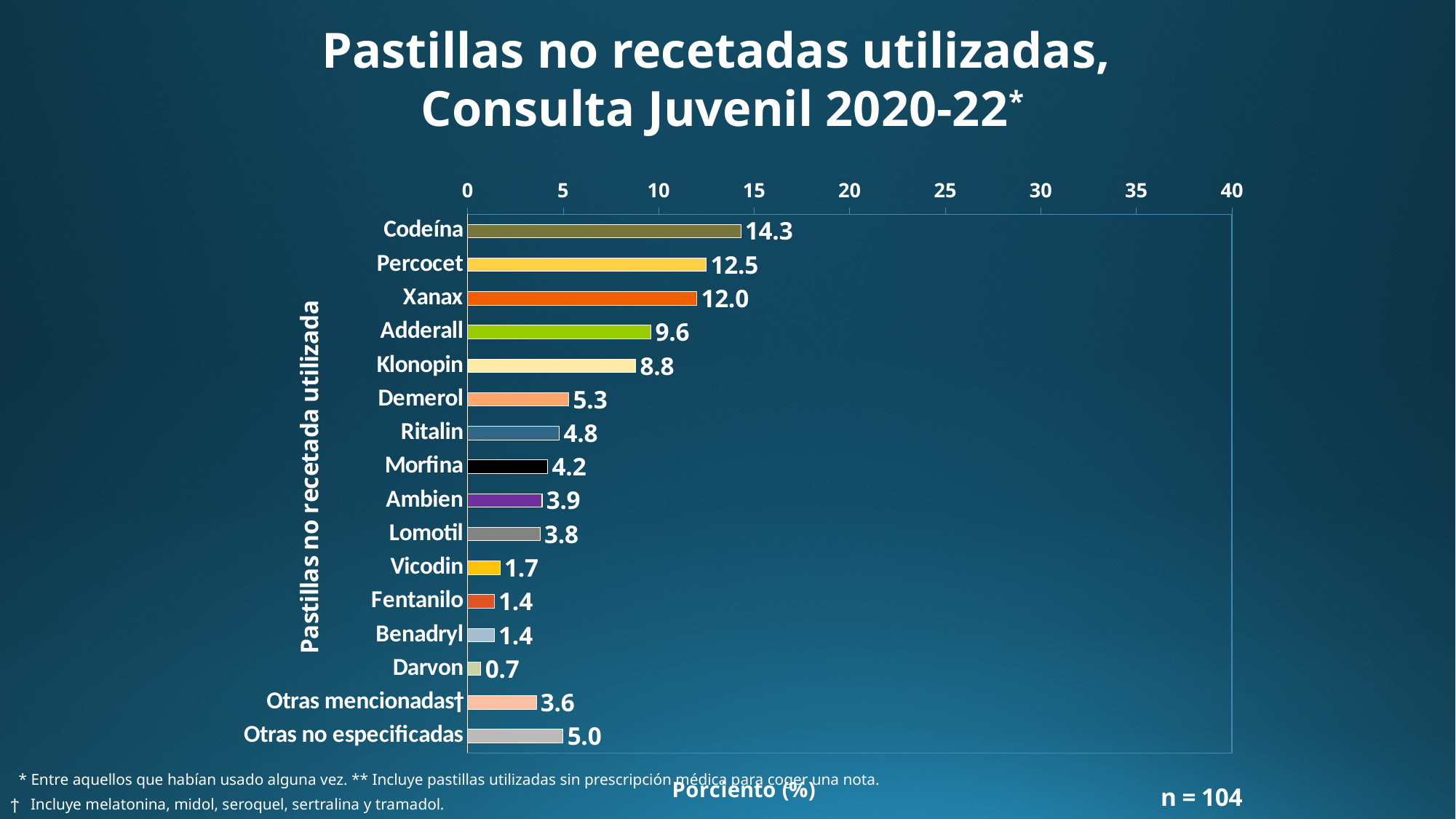
Which is larger, the value for Adderall or the value for Demerol? Adderall What is the difference between the values for Percocet and Xanax? 0.5 Is the value for Xanax greater or less than 10? greater What is the value for Otras no especificadas? 5.0 What is the value for Klonopin? 8.8 Which category has the lowest value? Darvon What is the label of the horizontal axis? Porciento (%) What is the sample size shown on the slide? n = 104 What is the value for Codeína? 14.3 What kind of chart is this? bar chart How many categories are shown on the chart? 16 Which category has the highest value? Codeína